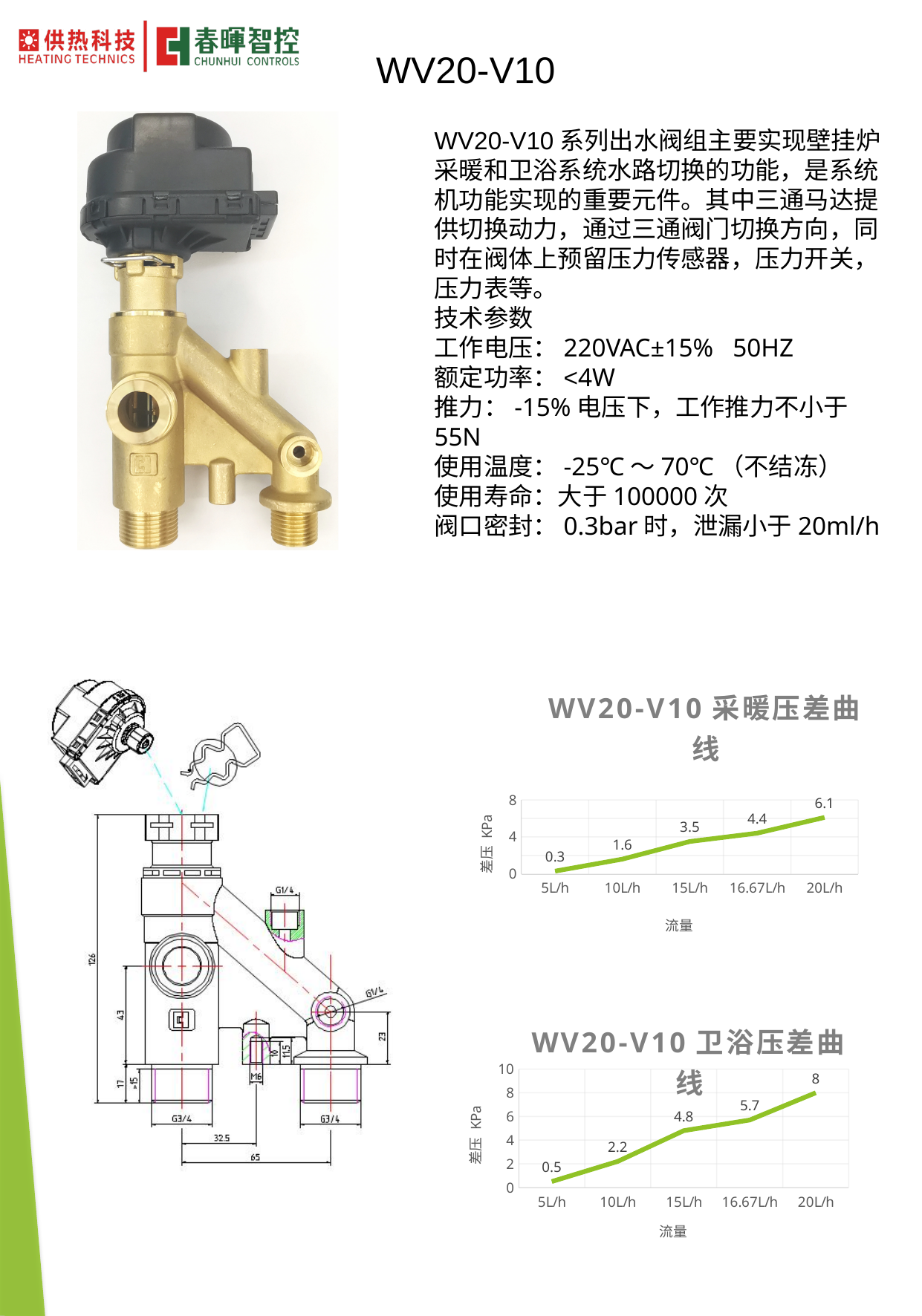
How many data points are plotted in the WV20-V10 采暖压差曲线 chart? 5 In the WV20-V10 卫浴压差曲线 chart, do the values rise or fall as the flow rate increases? Rise What type of chart is the WV20-V10 卫浴压差曲线 chart? Line chart In the WV20-V10 卫浴压差曲线 chart, which flow rate has the highest pressure difference? 20L/h In the WV20-V10 采暖压差曲线 chart, what is the pressure difference at 15L/h? 3.5 In the WV20-V10 采暖压差曲线 chart, what is the difference between the values at 20L/h and 5L/h? 5.8 In the WV20-V10 卫浴压差曲线 chart, what is the difference between the values at 15L/h and 10L/h? 2.6 Which is larger: the value at 15L/h in the WV20-V10 采暖压差曲线 chart or the value at 15L/h in the WV20-V10 卫浴压差曲线 chart? WV20-V10 卫浴压差曲线 (4.8) In the WV20-V10 采暖压差曲线 chart, what is the value at 20L/h? 6.1 In the WV20-V10 卫浴压差曲线 chart, what is the pressure difference at 10L/h? 2.2 In the WV20-V10 卫浴压差曲线 chart, what is the value at 16.67L/h? 5.7 In the WV20-V10 采暖压差曲线 chart, which flow rate has the lowest pressure difference? 5L/h